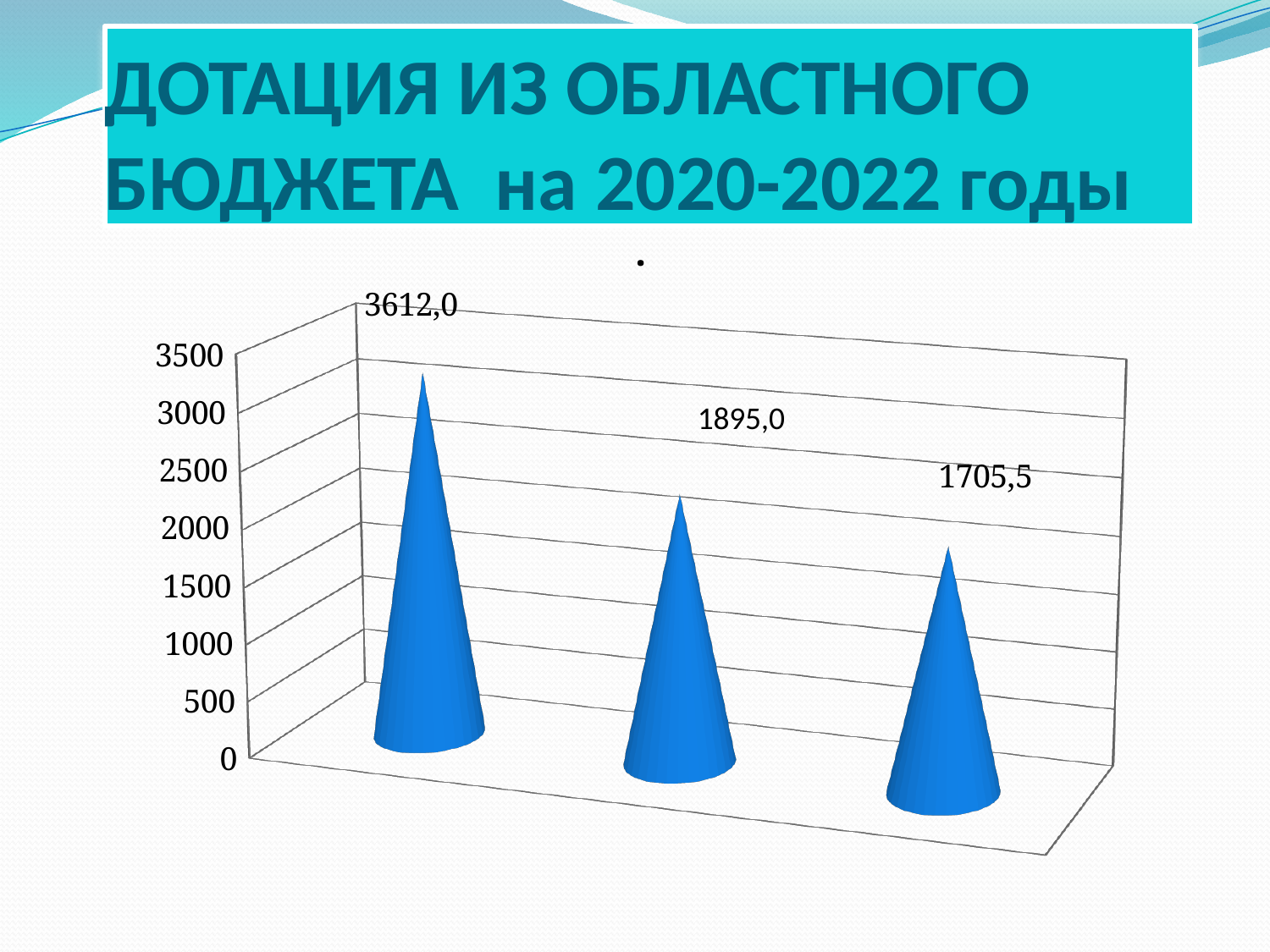
What value is labelled on the leftmost bar of the chart? 3612,0 What kind of chart is shown on the slide? bar chart Do the values rise or fall from left to right across the chart? fall What value is labelled on the rightmost bar of the chart? 1705,5 Which bar has the lowest value: the leftmost, middle or rightmost? rightmost What is the difference between the middle bar's value and the rightmost bar's value? 189,5 Which is larger, the value of the middle bar or the value of the rightmost bar? middle bar What value is labelled on the middle bar of the chart? 1895,0 What is the difference between the leftmost bar's value and the middle bar's value? 1717,0 How many bars are plotted in the chart? 3 Which bar has the highest value: the leftmost, middle or rightmost? leftmost